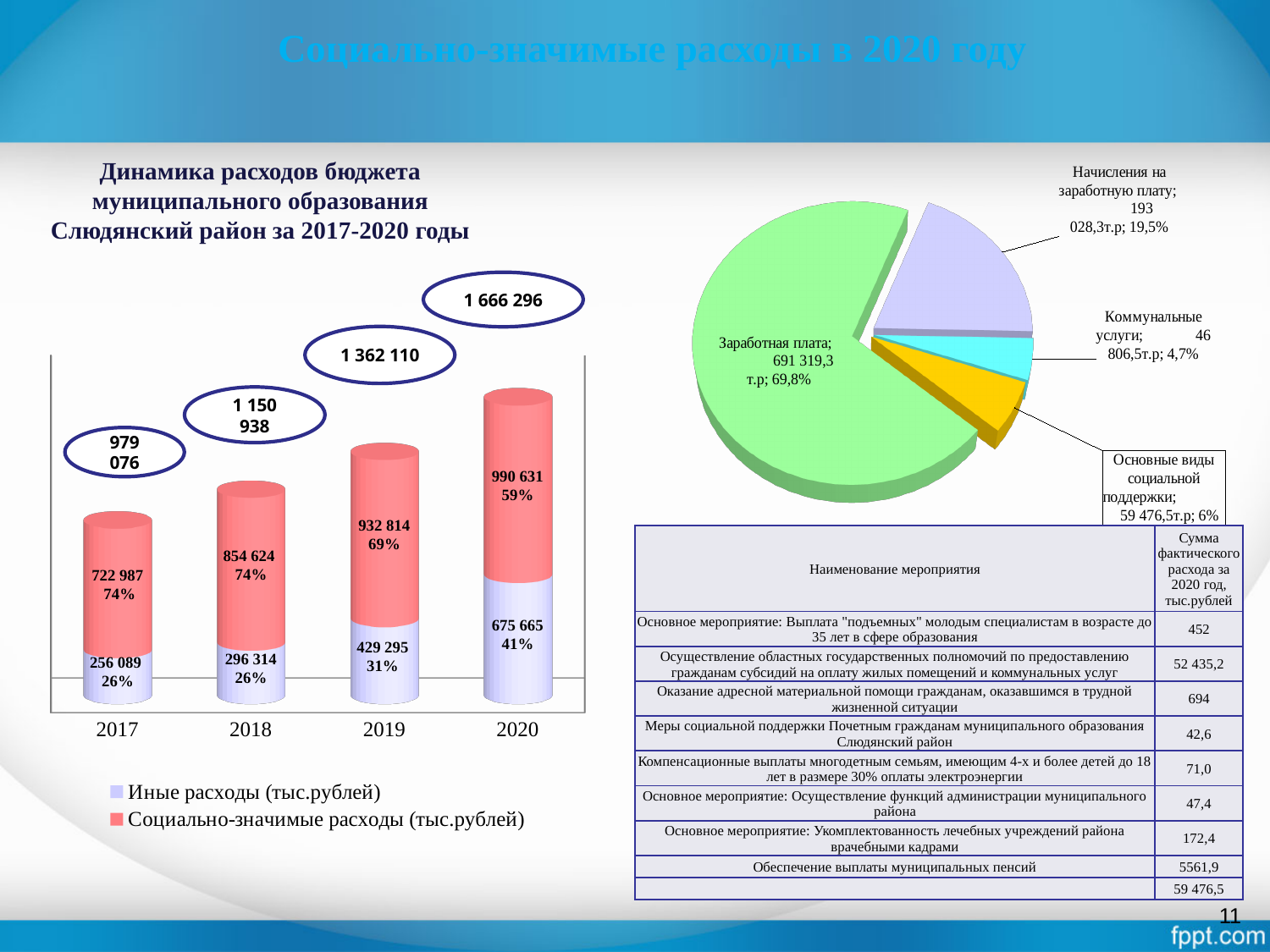
In the pie chart on the right, what is the value for Коммунальные услуги? 46 806,5т.р. In the bar chart on the left, what is the value of Социально-значимые расходы for 2019? 932 814 In the bar chart on the left, which year has the highest value of Социально-значимые расходы? 2020 In the pie chart on the right, what share does Заработная плата have? 69,8% In the bar chart on the left, which year has the lowest value of Иные расходы? 2017 How many series does the legend of the bar chart on the left list? 2 In the bar chart on the left, what percentage share do Иные расходы make up in 2020? 41% In the bar chart on the left, what is the total shown above the 2020 bar? 1 666 296 What type of chart is shown on the right side of the slide? pie chart In the bar chart on the left, what is the value of Иные расходы for 2017? 256 089 In the bar chart on the left, what is the difference between Социально-значимые расходы in 2018 and in 2017? 131 637 In the bar chart on the left, do the total expenditures rise or fall from 2017 to 2020? rise